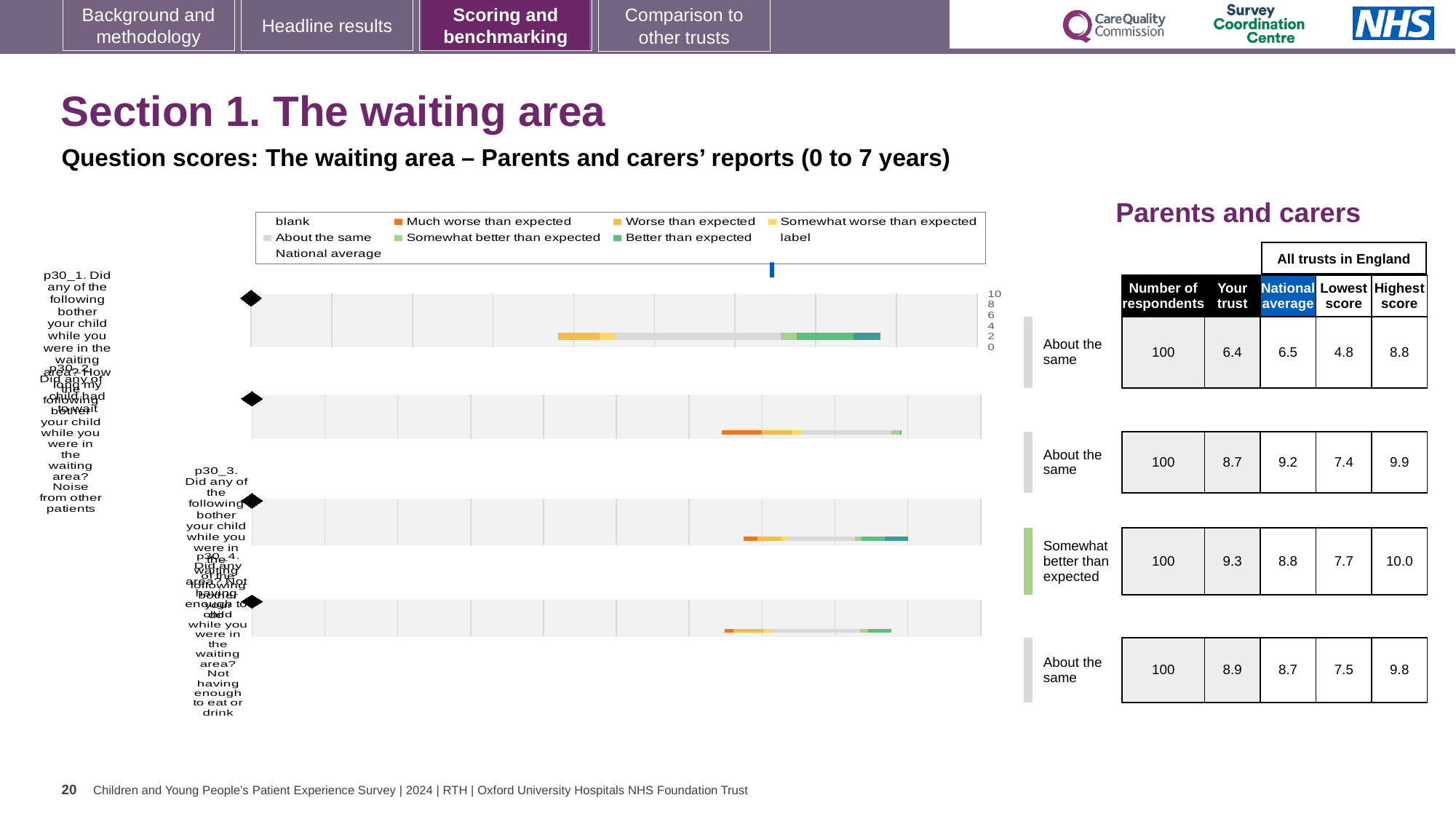
In the table beside the chart, which row has the lowest 'Your trust' score? the first row (6.4) In the table beside the chart, which row has the highest 'Your trust' score? the third row (9.3) How many question rows (bars) does the chart show? 4 What kind of chart is shown on the slide? bar chart In the chart legend, what colour represents 'Much worse than expected'? orange For the third row, is the 'Your trust' score or the national average larger? Your trust (9.3) In the table beside the chart, how many respondents are listed for each row? 100 In the table beside the chart, what is the highest score for the third row? 10.0 For the third row, what is the difference between the 'Your trust' score and the national average? 0.5 In the table beside the chart, what is the national average for the second row? 9.2 In the table beside the chart, what is the 'Your trust' score for the first row? 6.4 In the table beside the chart, what is the lowest score for the fourth row? 7.5